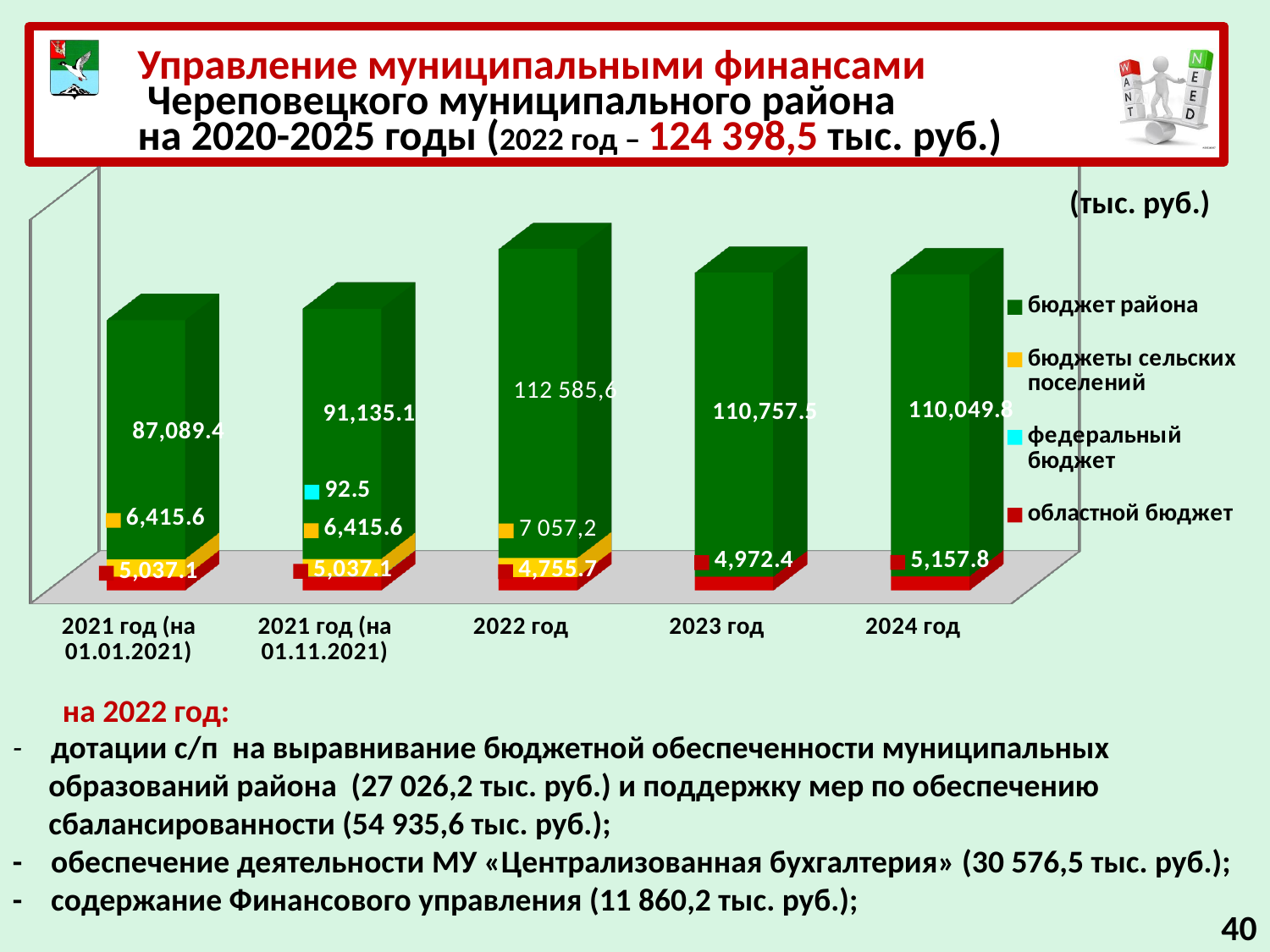
What is the value of областной бюджет for 2024 год? 5,157.8 What is the value of федеральный бюджет for 2021 год (на 01.11.2021)? 92.5 Which is larger: областной бюджет for 2023 год or for 2024 год? 2024 год What type of chart is shown on the slide? bar chart Which period has the highest value for бюджет района? 2022 год What is the value of бюджеты сельских поселений for 2022 год? 7 057,2 Which period has the lowest value for областной бюджет? 2022 год How many categories (periods) are shown on the x axis of the chart? 5 How many series does the chart legend list? 4 What is the difference between областной бюджет for 2024 год and for 2023 год? 185.4 Which series is shown in green in the chart? бюджет района What is the value of бюджет района for 2021 год (на 01.11.2021)? 91,135.1